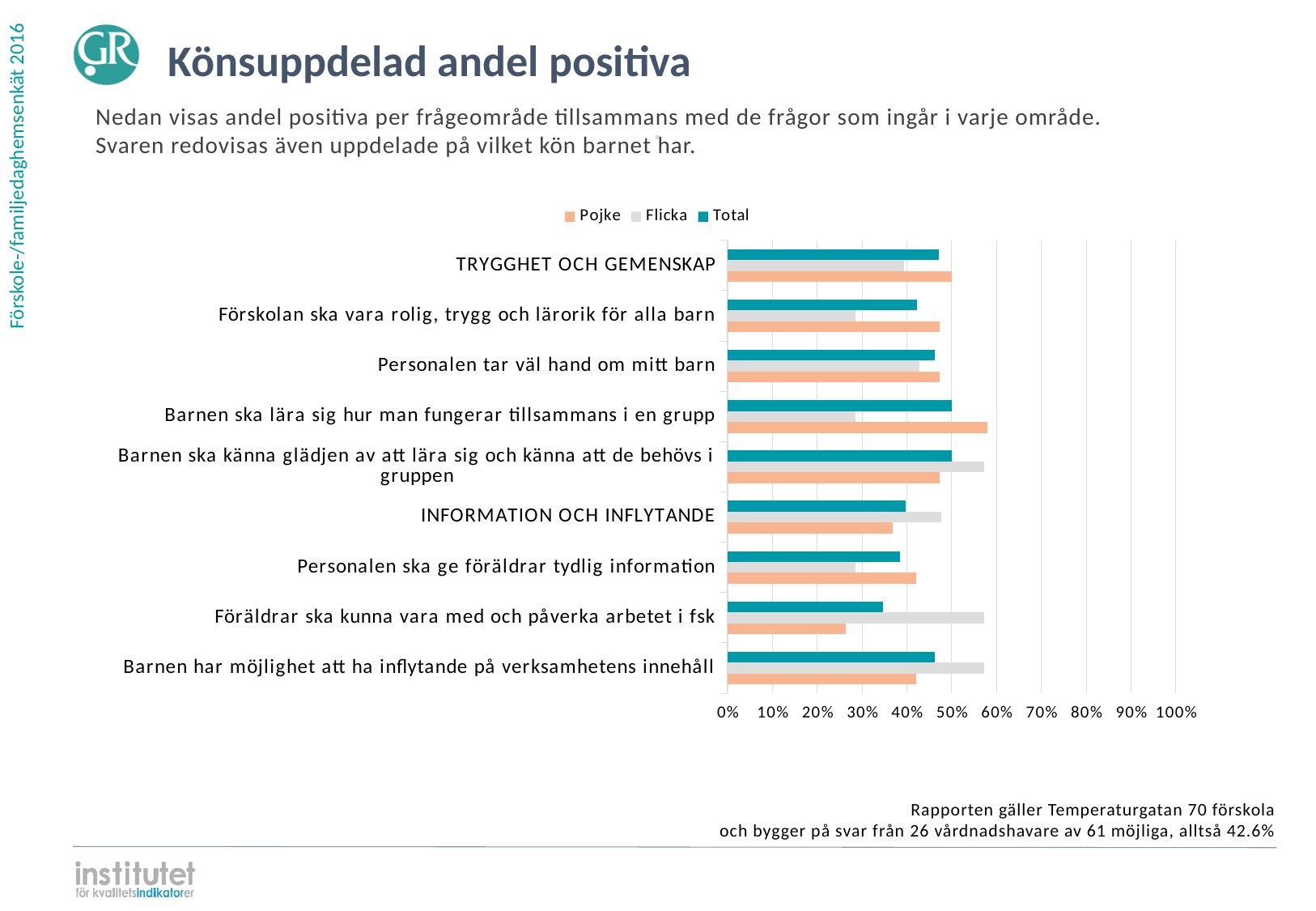
For 'Föräldrar ska kunna vara med och påverka arbetet i fsk', which is larger: the Pojke value or the Flicka value? Flicka Is the Flicka value for 'Förskolan ska vara rolig, trygg och lärorik för alla barn' greater or less than 40%? less Is the Pojke value for 'Barnen ska lära sig hur man fungerar tillsammans i en grupp' greater or less than 50%? greater For which category is the Pojke value lowest? Föräldrar ska kunna vara med och påverka arbetet i fsk How many series does the chart legend list? 3 Is the Total value for 'INFORMATION OCH INFLYTANDE' greater or less than 50%? less For which category is the Pojke value highest? Barnen ska lära sig hur man fungerar tillsammans i en grupp What kind of chart is shown on the slide? Bar chart Which series are listed in the chart legend? Pojke, Flicka, Total How many categories are shown on the chart? 9